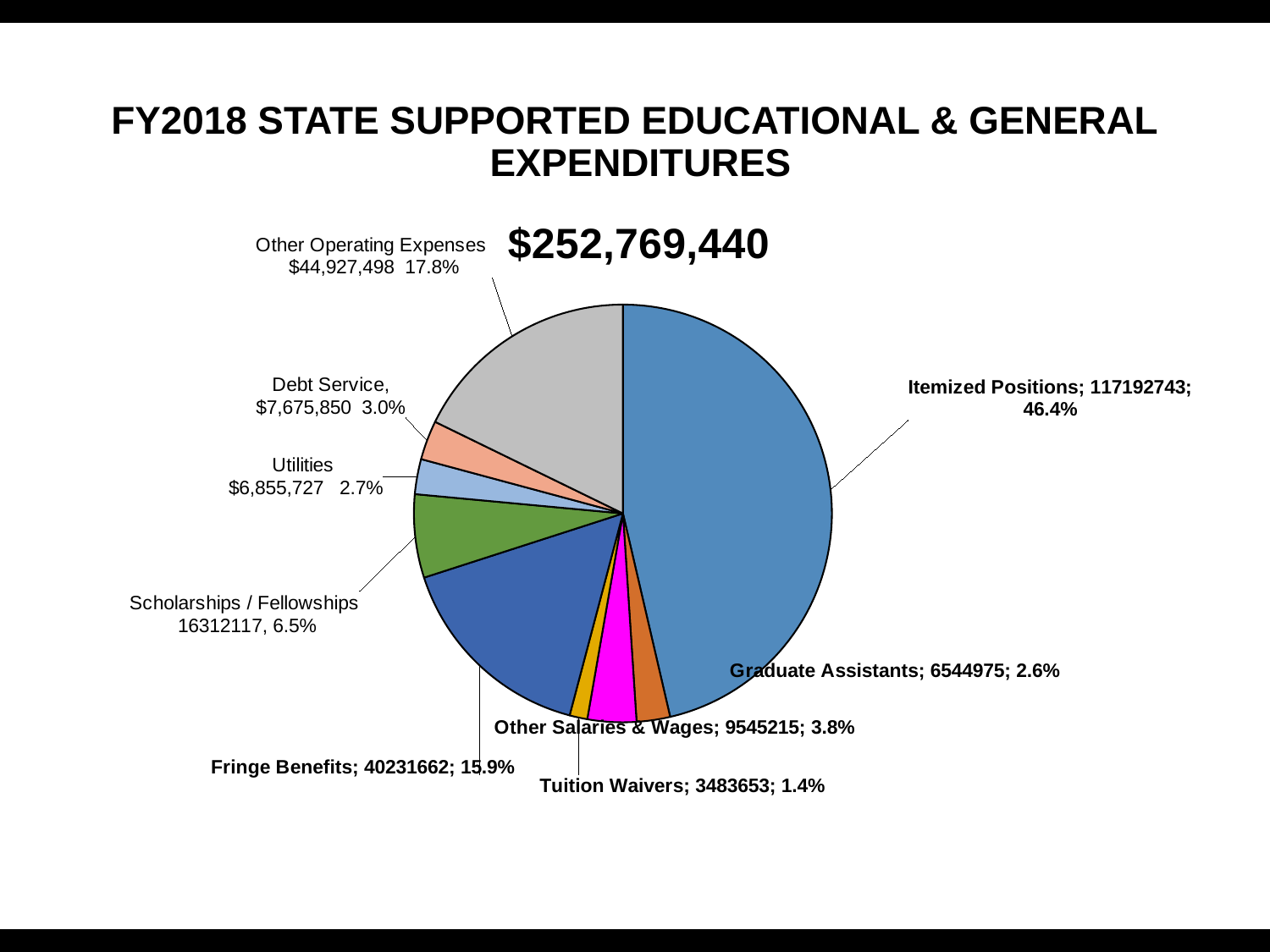
Which is larger, the share for Debt Service or the share for Scholarships / Fellowships? Scholarships / Fellowships What is the difference in percentage points between the Fringe Benefits share and the Other Salaries & Wages share? 12.1 What percentage share does Other Operating Expenses have? 17.8% What is the value shown for Fringe Benefits? 40231662 What kind of chart is shown on the slide? pie chart Which category has the largest share of the pie? Itemized Positions How many slices does the pie chart have? 9 Which category has the smallest share of the pie? Tuition Waivers What is the value shown for Itemized Positions? 117192743 What total amount is printed above the pie chart? $252,769,440 What is the value shown for Utilities? $6,855,727